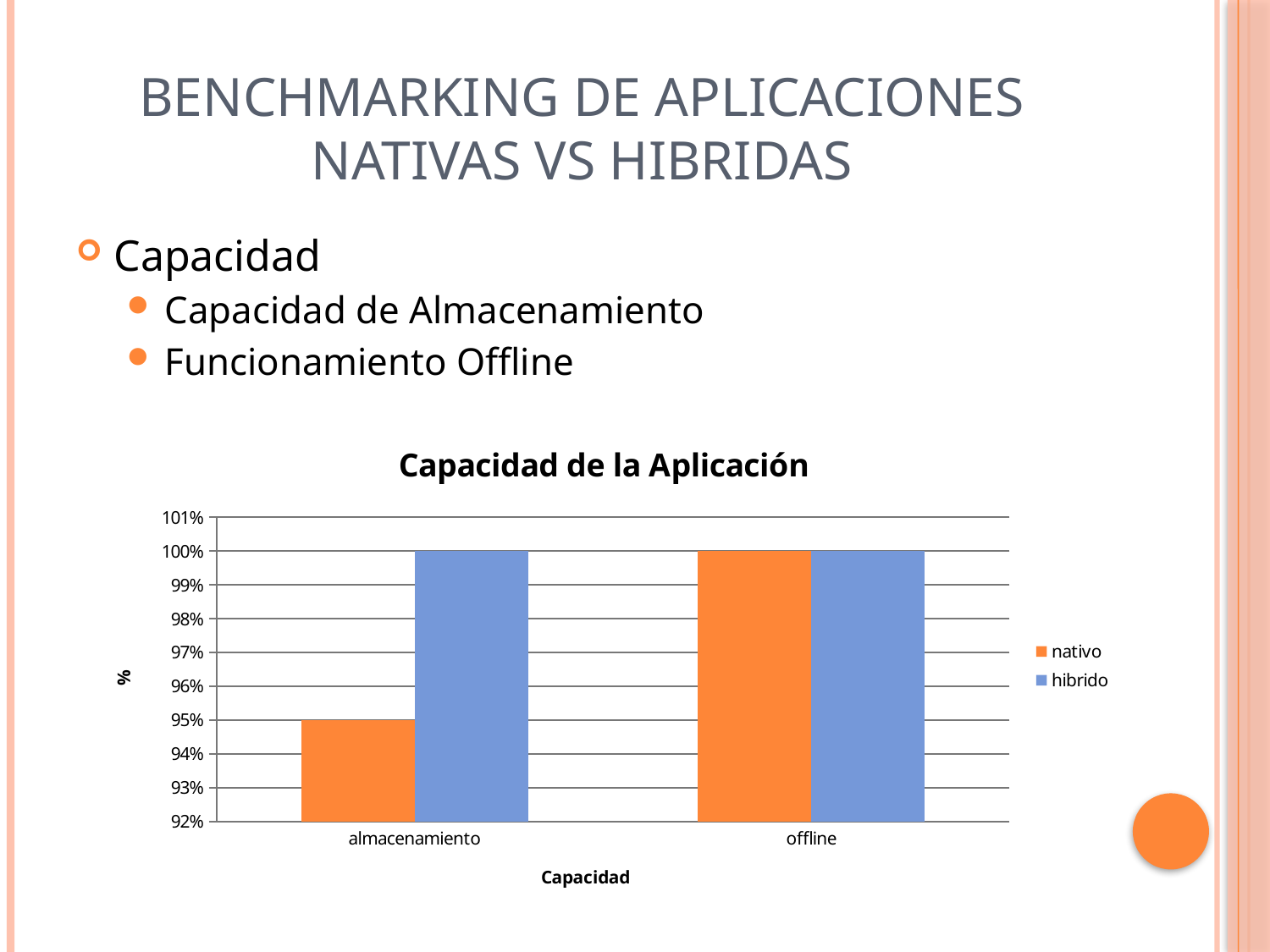
What is the value for hibrido in the offline category? 100% Is the value for nativo in the almacenamiento category greater or less than 97%? less What is the title of the chart? Capacidad de la Aplicación Which series has the lower value in the almacenamiento category? nativo What is the value for nativo in the almacenamiento category? 95% What is the difference between hibrido and nativo in the almacenamiento category? 5% In the almacenamiento category, which is larger, nativo or hibrido? hibrido How many categories are shown on the x axis of the chart? 2 What is the value for nativo in the offline category? 100% What kind of chart is shown on the slide? bar chart What is the value for hibrido in the almacenamiento category? 100% How many series does the chart legend list? 2